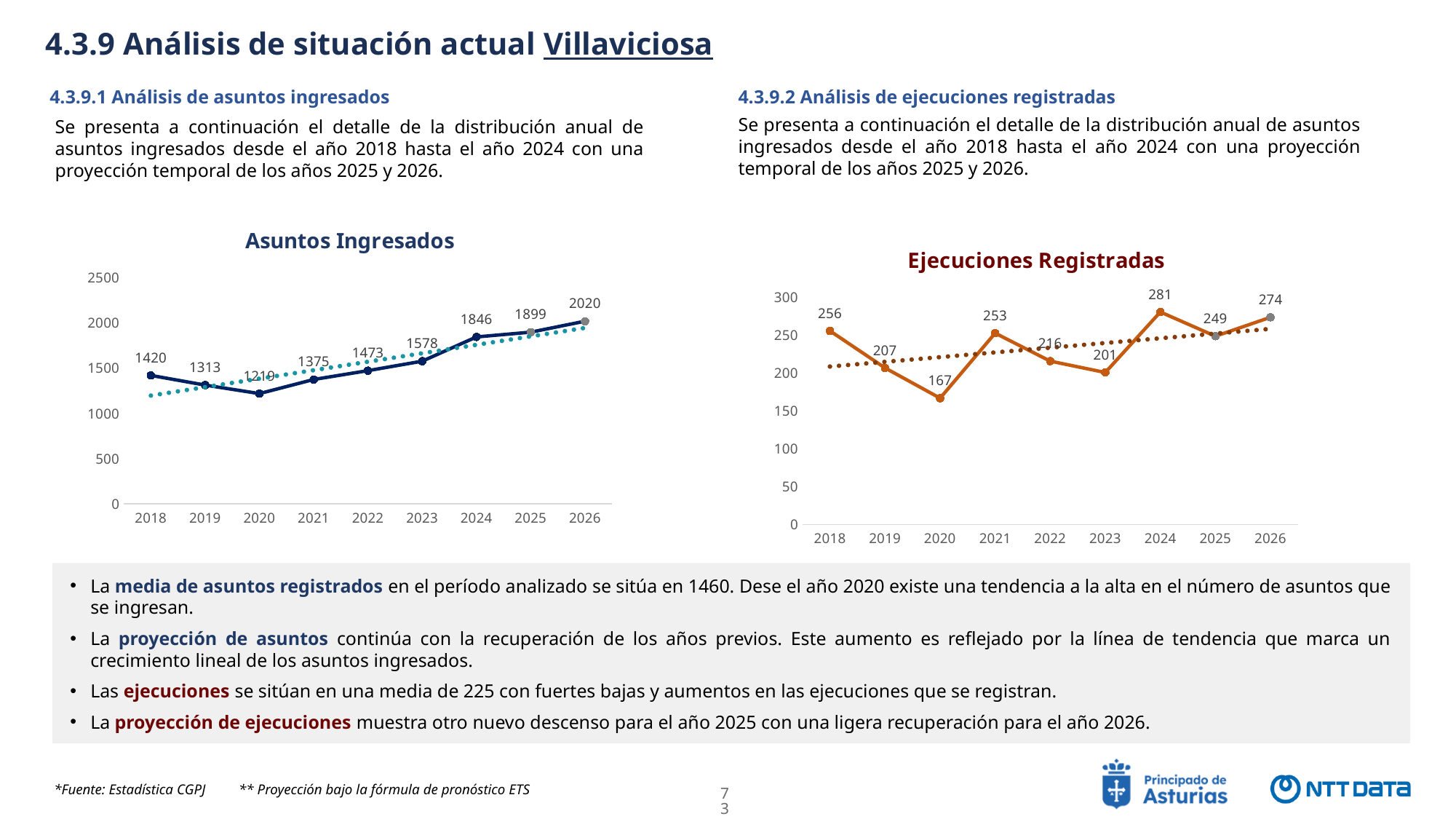
In the Asuntos Ingresados chart, what is the value for 2018? 1420 In the Ejecuciones Registradas chart, which year has the highest value? 2024 In the Ejecuciones Registradas chart, what is the difference between the values for 2024 and 2025? 32 In the Asuntos Ingresados chart, how many years are plotted on the x axis? 9 In the Ejecuciones Registradas chart, which year has the lowest value? 2020 What kind of chart is the Ejecuciones Registradas chart? Line chart In the Asuntos Ingresados chart, what is the difference between the values for 2026 and 2025? 121 In the Ejecuciones Registradas chart, which is larger, the value for 2018 or the value for 2021? 2018 In the Asuntos Ingresados chart, is the value for 2020 greater or less than 1500? less In the Asuntos Ingresados chart, what is the value for 2024? 1846 In the Asuntos Ingresados chart, which year has the highest value? 2026 In the Ejecuciones Registradas chart, what is the value for 2020? 167